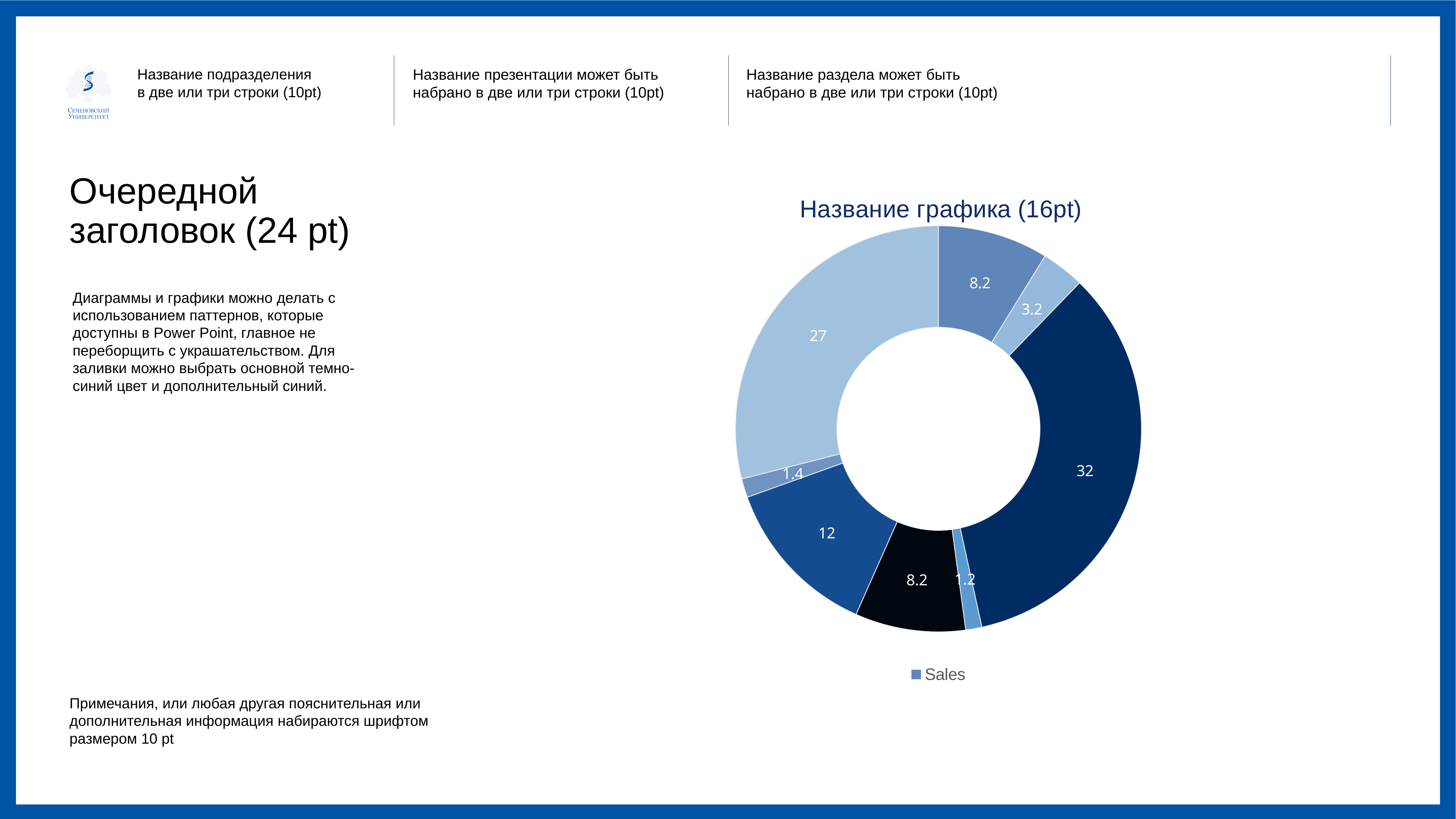
Which is larger: the black slice or the slice labelled 12? The slice labelled 12 What is the total of all slice values in the chart? 93.2 What is the value of the lightest blue slice, the second largest in the chart? 27 How many slices does the doughnut chart have? 8 What type of chart is shown on the slide? Doughnut (pie) chart How many series does the legend list? 1 What is the value of the black slice in the chart? 8.2 What is the value of the largest slice in the chart? 32 What is the title of the chart? Название графика (16pt) What is the value of the smallest slice in the chart? 1.2 What is the difference between the largest slice (32) and the second largest slice (27)? 5 What series name does the chart legend list? Sales